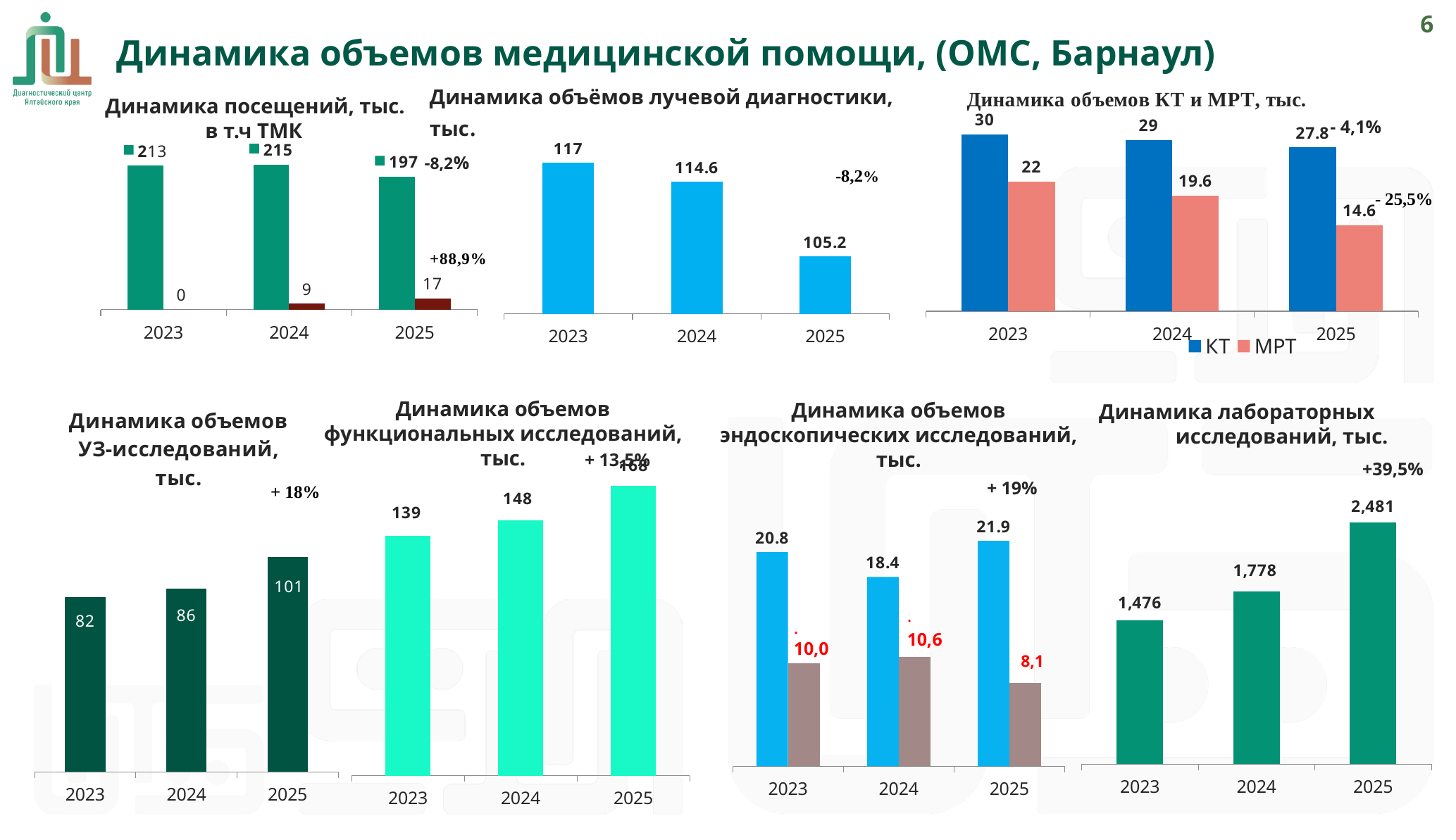
In the chart 'Динамика объемов КТ и МРТ, тыс.', what is the МРТ value for 2024? 19.6 How many years are shown on the x axis of the chart 'Динамика объёмов лучевой диагностики, тыс.'? 3 In the chart 'Динамика объемов УЗ-исследований, тыс.', which year has the lowest value? 2023 In the chart 'Динамика объемов КТ и МРТ, тыс.', what colour are the КТ bars? Blue In the chart 'Динамика посещений, тыс. в т.ч ТМК', what is the ТМК value (dark red bar) for 2025? 17 How many series does the legend of the chart 'Динамика объемов КТ и МРТ, тыс.' list? 2 In the chart 'Динамика объёмов лучевой диагностики, тыс.', what is the value for 2025? 105.2 In the chart 'Динамика объёмов лучевой диагностики, тыс.', do the values rise or fall from 2023 to 2025? Fall In the chart 'Динамика объемов функциональных исследований, тыс.', what is the difference between the 2025 and 2023 values? 29 In the chart 'Динамика объемов эндоскопических исследований, тыс.', which is larger: the blue bar for 2023 or the blue bar for 2024? 2023 In the chart 'Динамика лабораторных исследований, тыс.', which year has the highest value? 2025 What type of chart is 'Динамика объемов УЗ-исследований, тыс.'? Bar chart